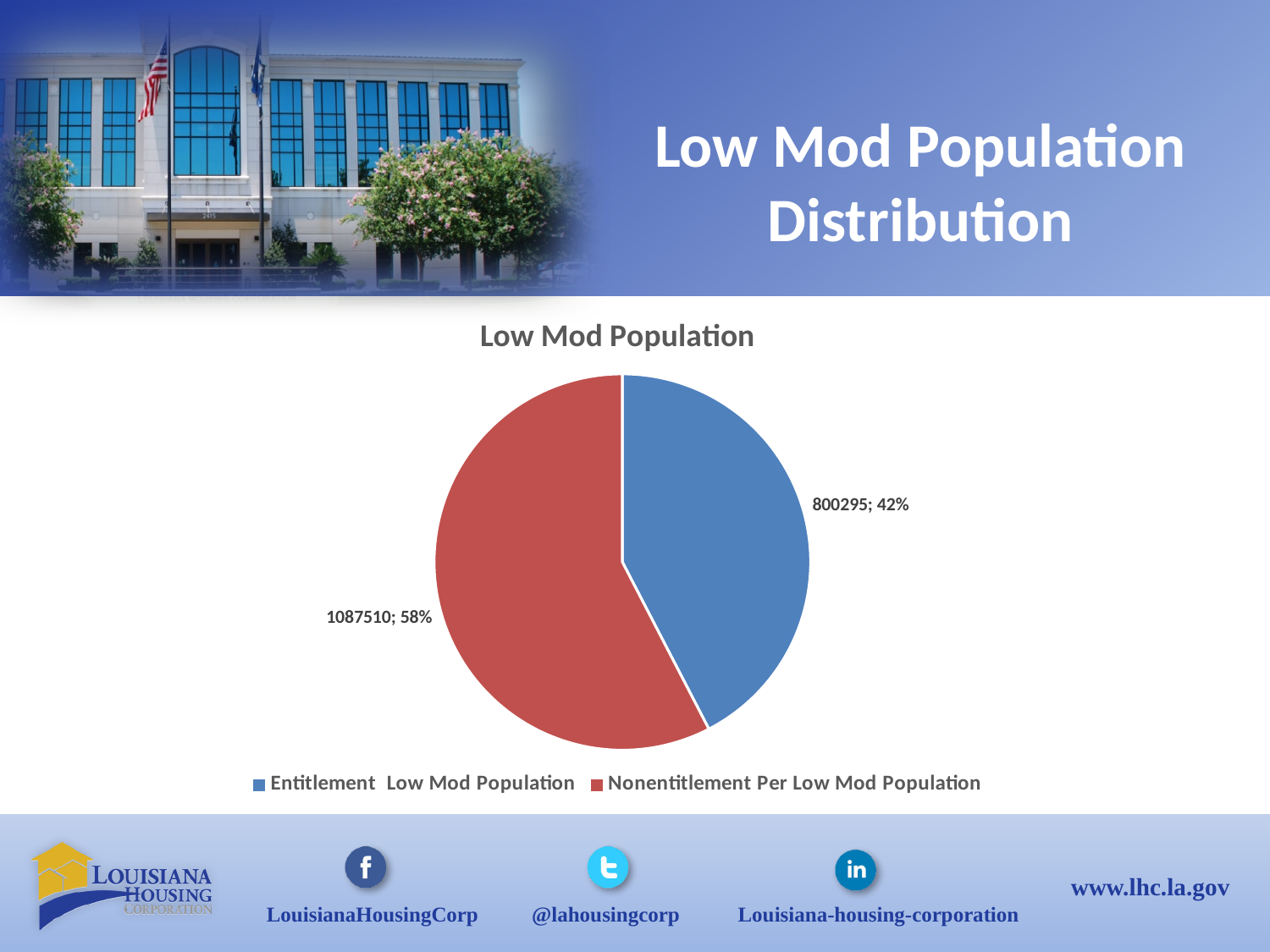
What is the title of the chart? Low Mod Population What type of chart is shown on the slide? pie chart Which colour represents Entitlement Low Mod Population in the pie chart? blue What is the value for Nonentitlement Per Low Mod Population? 1087510 How many slices does the pie chart have? 2 Which category has the largest slice? Nonentitlement Per Low Mod Population What share of the pie does Entitlement Low Mod Population represent? 42% Which category has the smallest slice? Entitlement Low Mod Population What is the difference between the Nonentitlement Per Low Mod Population value and the Entitlement Low Mod Population value? 287215 What is the value for Entitlement Low Mod Population? 800295 What share of the pie does Nonentitlement Per Low Mod Population represent? 58% How many entries does the legend list? 2